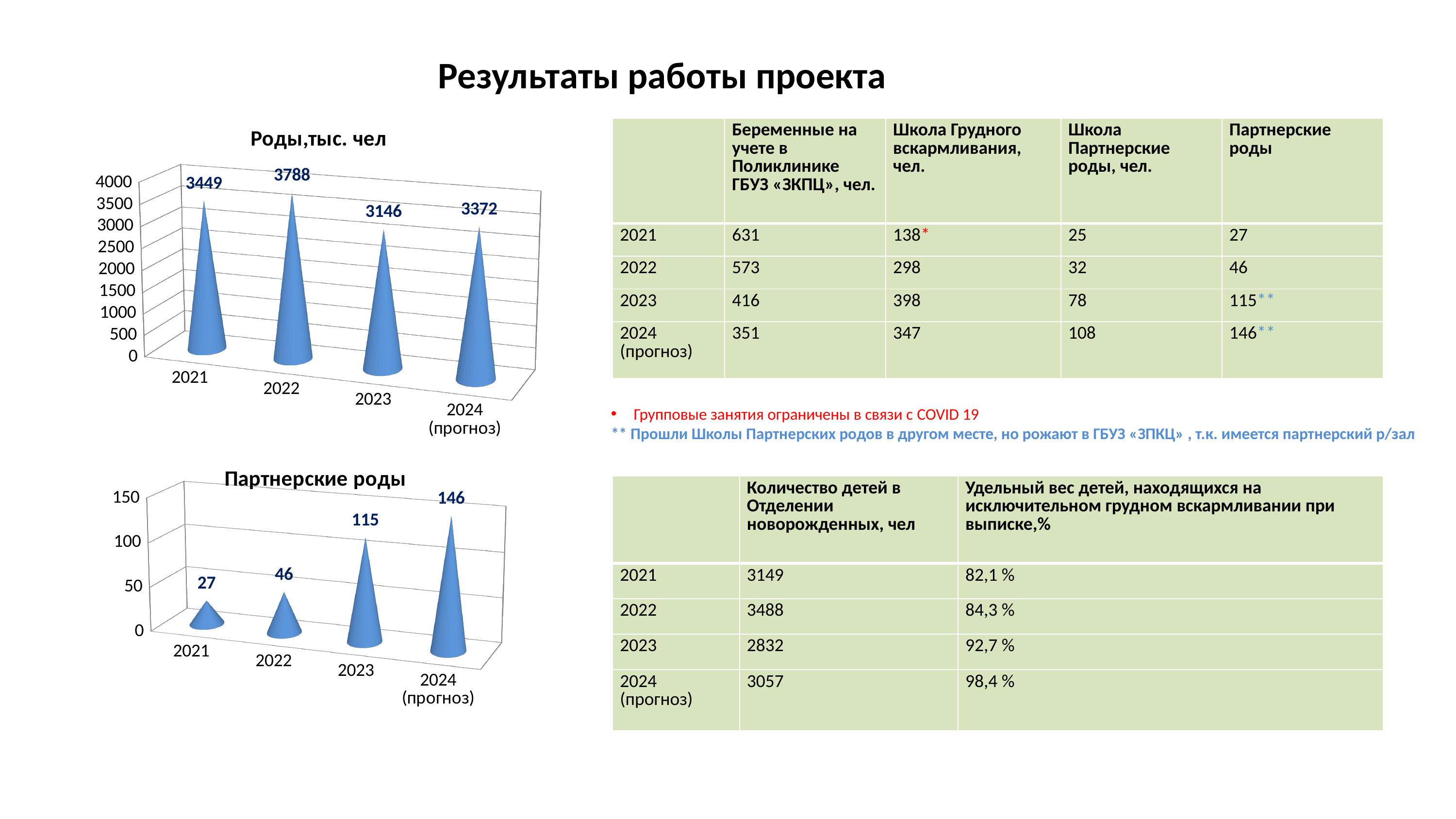
In the chart titled "Партнерские роды", what is the value for 2021? 27 In the chart titled "Роды,тыс. чел", which year has the lowest value? 2023 In the chart titled "Роды,тыс. чел", what is the difference between the values for 2022 and 2021? 339 In the chart titled "Партнерские роды", what is the difference between the values for 2024 (прогноз) and 2023? 31 In the chart titled "Роды,тыс. чел", what is the value for 2022? 3788 In the chart titled "Роды,тыс. чел", what is the value for 2024 (прогноз)? 3372 In the chart titled "Партнерские роды", what is the value for 2023? 115 In the chart titled "Роды,тыс. чел", which year has the highest value? 2022 In the chart titled "Партнерские роды", which year has the highest value? 2024 (прогноз) In the chart titled "Роды,тыс. чел", how many categories are shown on the x axis? 4 What kind of chart is the chart titled "Партнерские роды"? bar chart In the chart titled "Партнерские роды", do the values rise or fall from 2021 to 2024 (прогноз)? rise